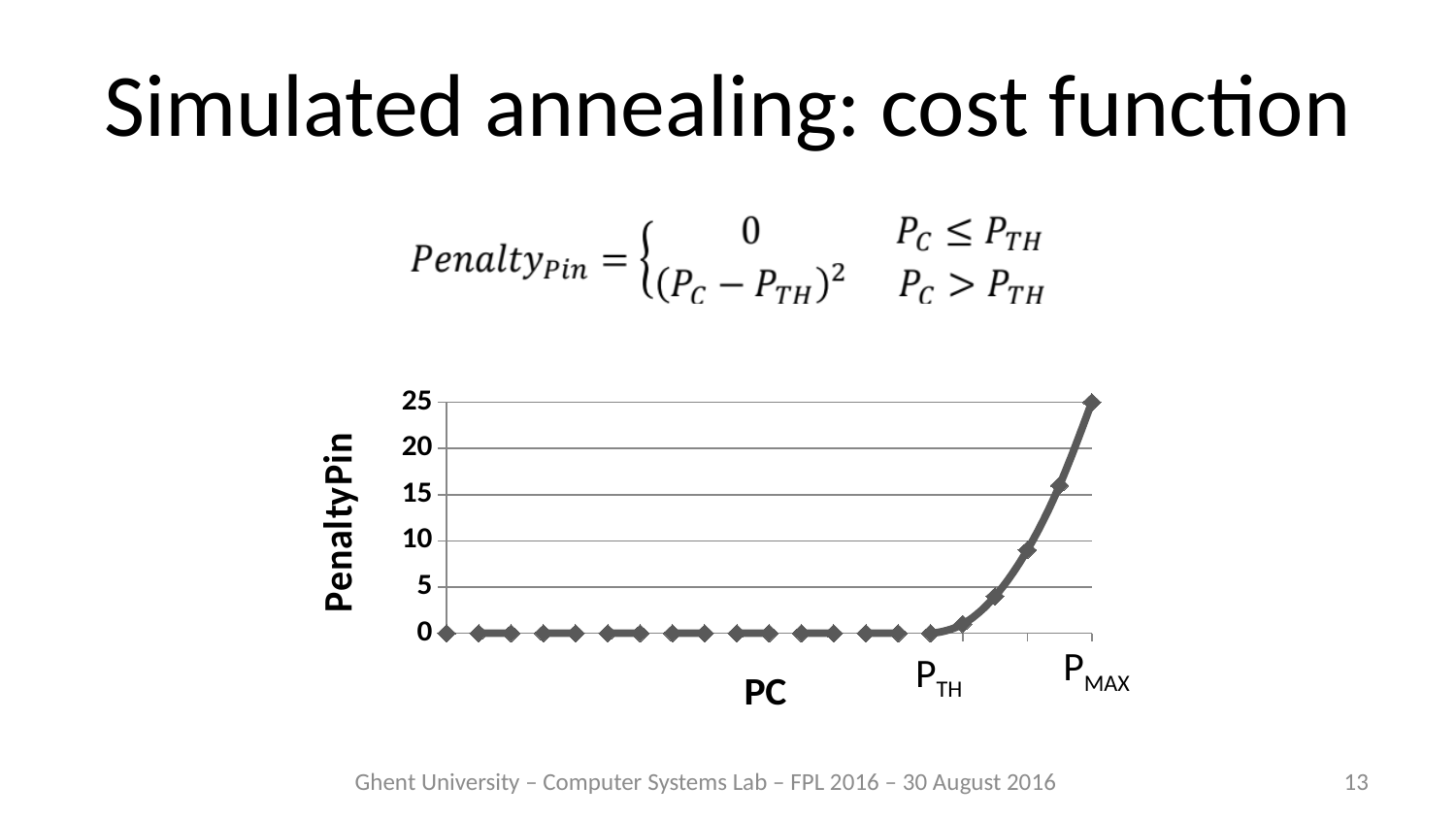
What is the difference between the PenaltyPin value at P_MAX and at P_TH? 25 What is the value of PenaltyPin at P_MAX? 25 What is the title of the horizontal axis of the chart? PC Which is larger, the PenaltyPin value at P_MAX or at P_TH? P_MAX Is the PenaltyPin value of the point immediately before P_MAX greater or less than 10? greater What kind of chart is shown on the slide? line chart At which labelled point on the x axis is PenaltyPin highest? P_MAX Is the PenaltyPin value at P_TH greater or less than 5? less How does PenaltyPin behave as PC increases from the left of the chart up to P_TH? it stays flat at 0 How does PenaltyPin behave as PC increases beyond P_TH? it rises What is the title of the vertical axis of the chart? PenaltyPin What is the value of PenaltyPin at P_TH? 0